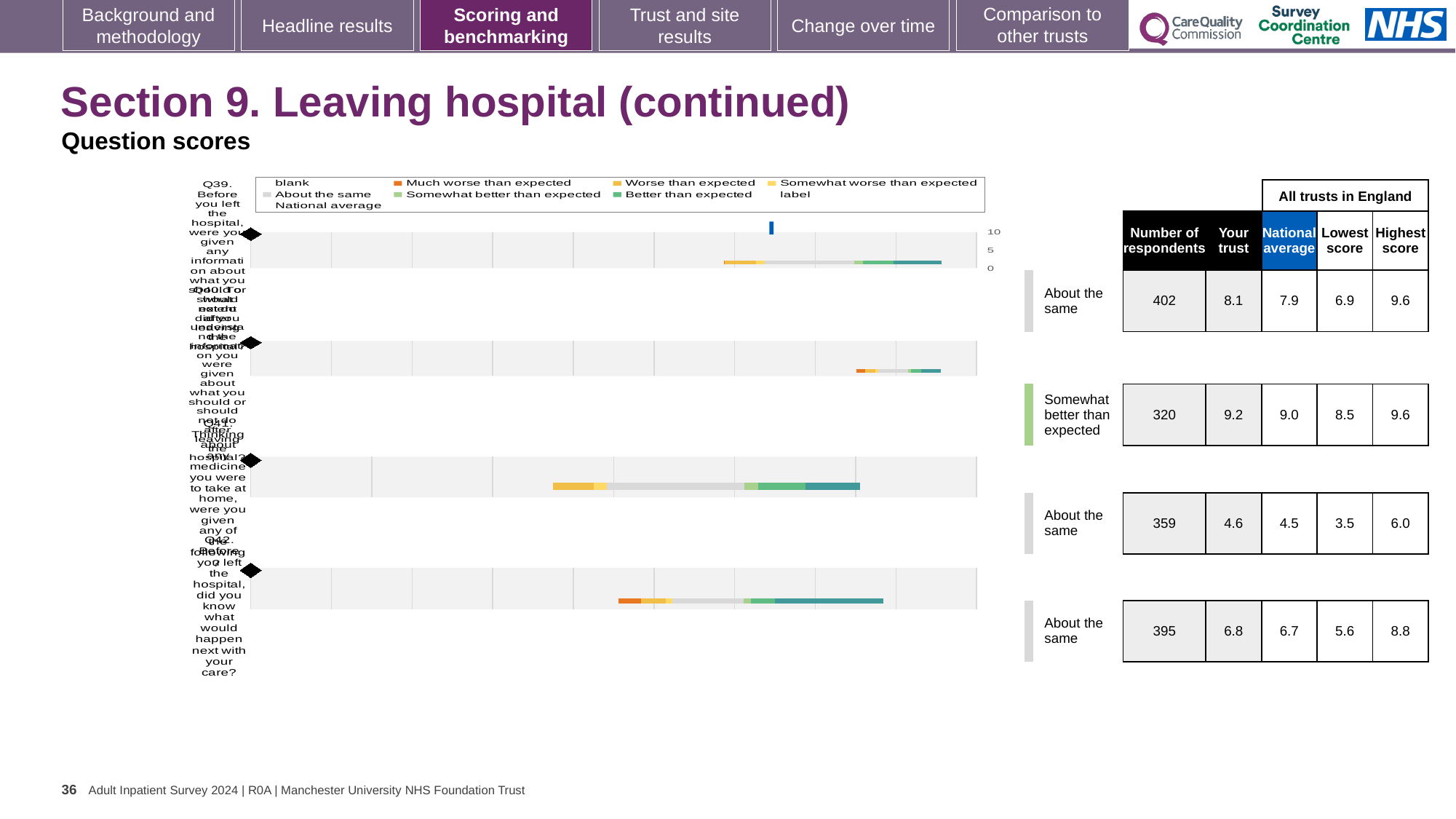
What is the Highest score among all trusts in England for the third row? 6.0 For the fourth row (Q42), which is larger: the 'Your trust' score or the National average? Your trust (6.8) Which row has the lowest 'Your trust' score in the table? the third row (4.6) In the table, what is the National average for the second row? 9.0 What kind of chart is shown on the left of the slide? bar chart How many question rows (bars) does the chart on the left show? 4 What benchmark category is shown for the second row? Somewhat better than expected How many respondents are listed for the fourth row (Q42)? 395 For the first row (Q39), what is the difference between the 'Your trust' score and the National average? 0.2 What is the Lowest score among all trusts in England for the first row (Q39)? 6.9 In the table, what is the 'Your trust' score for the first row (Q39)? 8.1 Which row has the highest 'Your trust' score in the table? the second row (9.2)